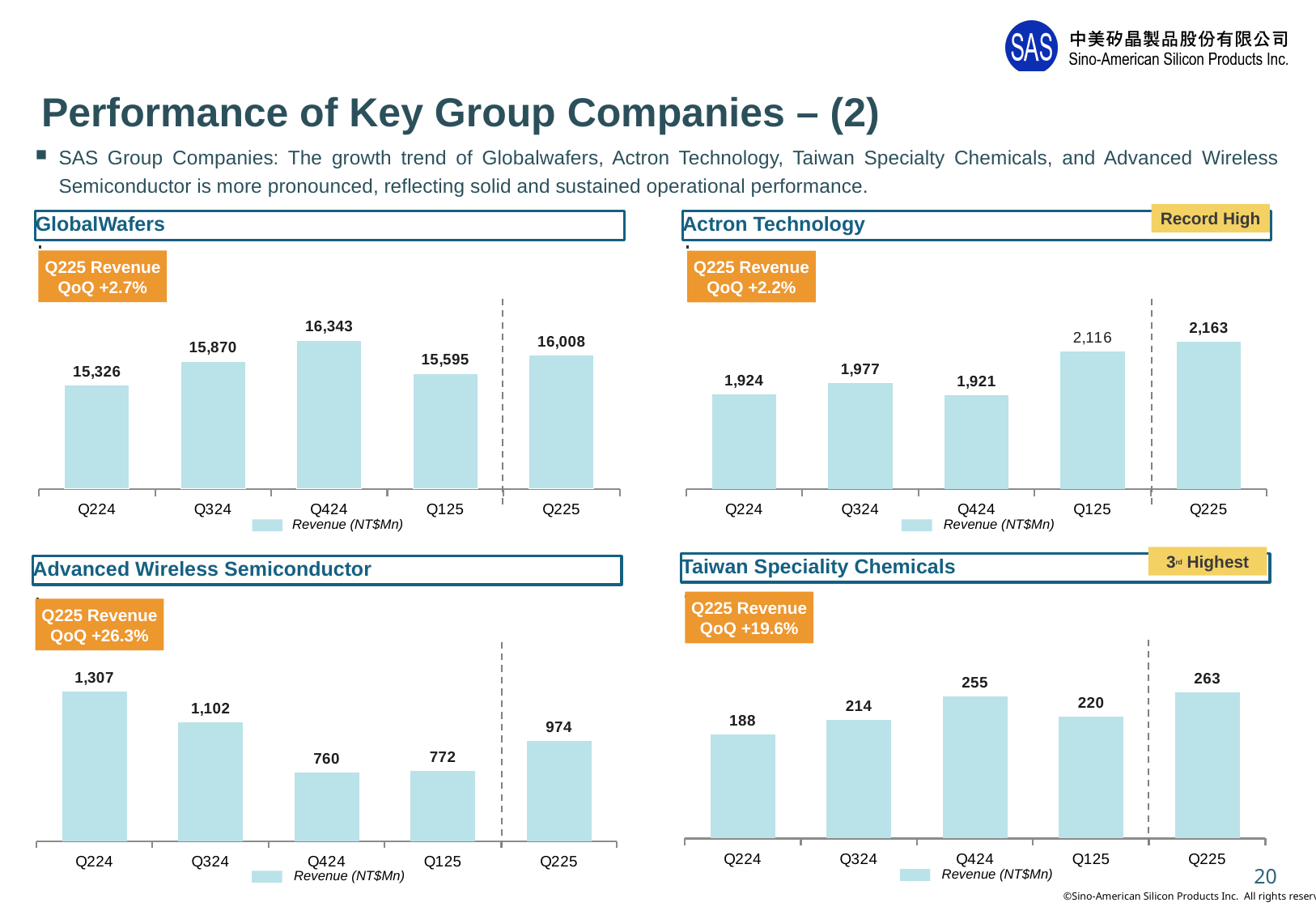
In the Advanced Wireless Semiconductor chart, what is the revenue for Q324? 1,102 In the Advanced Wireless Semiconductor chart, what is the difference between Q224 and Q225 revenue? 333 In the Actron Technology chart, what is the revenue for Q225? 2,163 In the Actron Technology chart, is the revenue for Q324 larger or smaller than for Q424? larger In the GlobalWafers chart, what is the difference between Q225 and Q125 revenue? 413 How many quarters are shown in the Taiwan Speciality Chemicals chart? 5 In the Actron Technology chart, which quarter has the highest revenue? Q225 In the GlobalWafers chart, which quarter has the lowest revenue? Q224 In the Advanced Wireless Semiconductor chart, which quarter has the lowest revenue? Q424 What type of chart is the GlobalWafers chart? bar chart In the Taiwan Speciality Chemicals chart, what is the revenue for Q424? 255